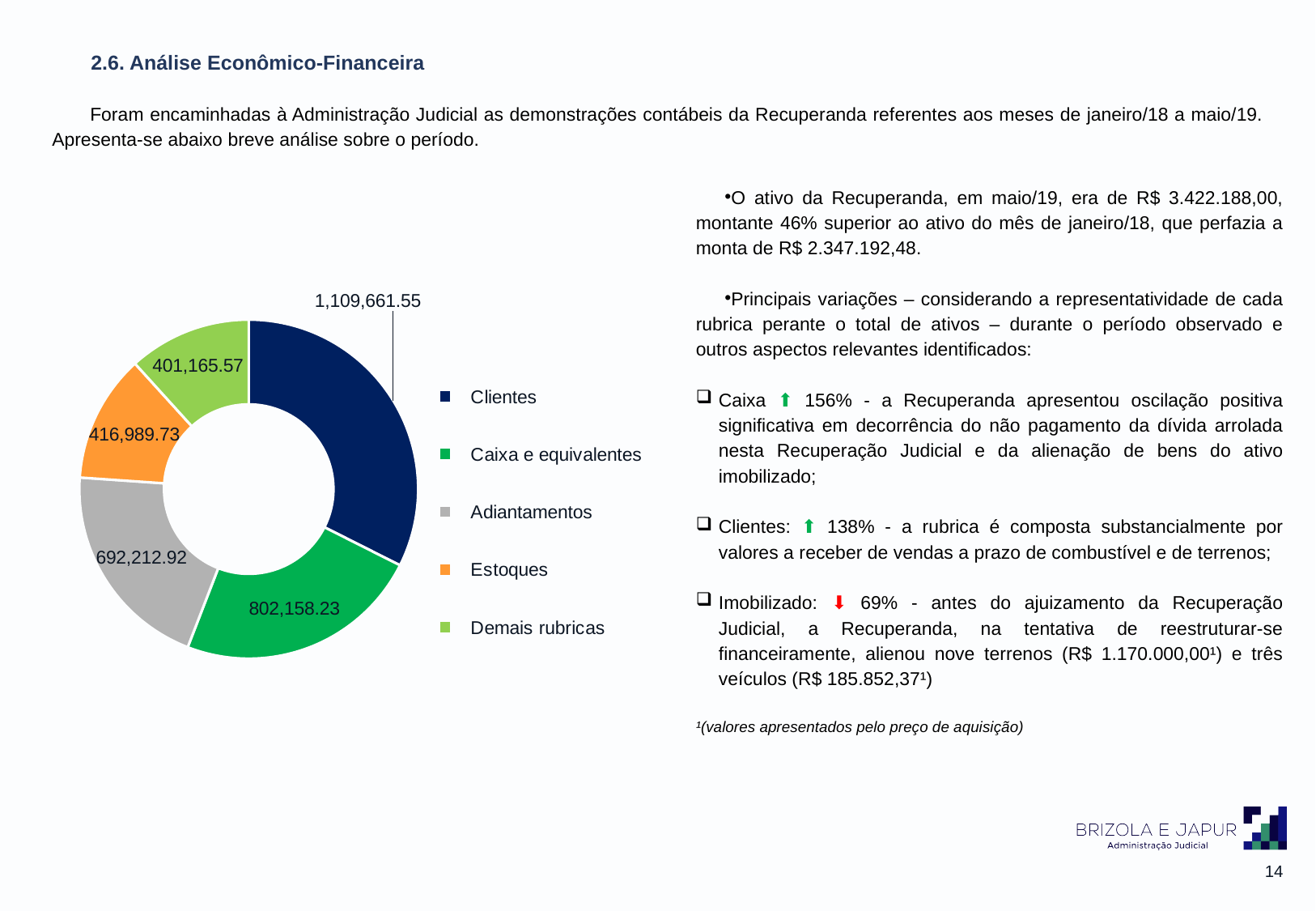
What is the value shown for Demais rubricas in the doughnut chart? 401,165.57 Which category has the largest slice in the doughnut chart? Clientes What is the difference between the values for Clientes and Caixa e equivalentes? 307,503.32 What type of chart is shown on the slide? Doughnut chart Which category has the smallest slice in the doughnut chart? Demais rubricas How many categories are shown in the doughnut chart? 5 Which is larger, the value for Adiantamentos or the value for Estoques? Adiantamentos What is the value shown for Clientes in the doughnut chart? 1,109,661.55 What is the value shown for Caixa e equivalentes in the doughnut chart? 802,158.23 What is the value shown for Adiantamentos in the doughnut chart? 692,212.92 What is the value shown for Estoques in the doughnut chart? 416,989.73 What colour is the Estoques slice in the doughnut chart? Orange